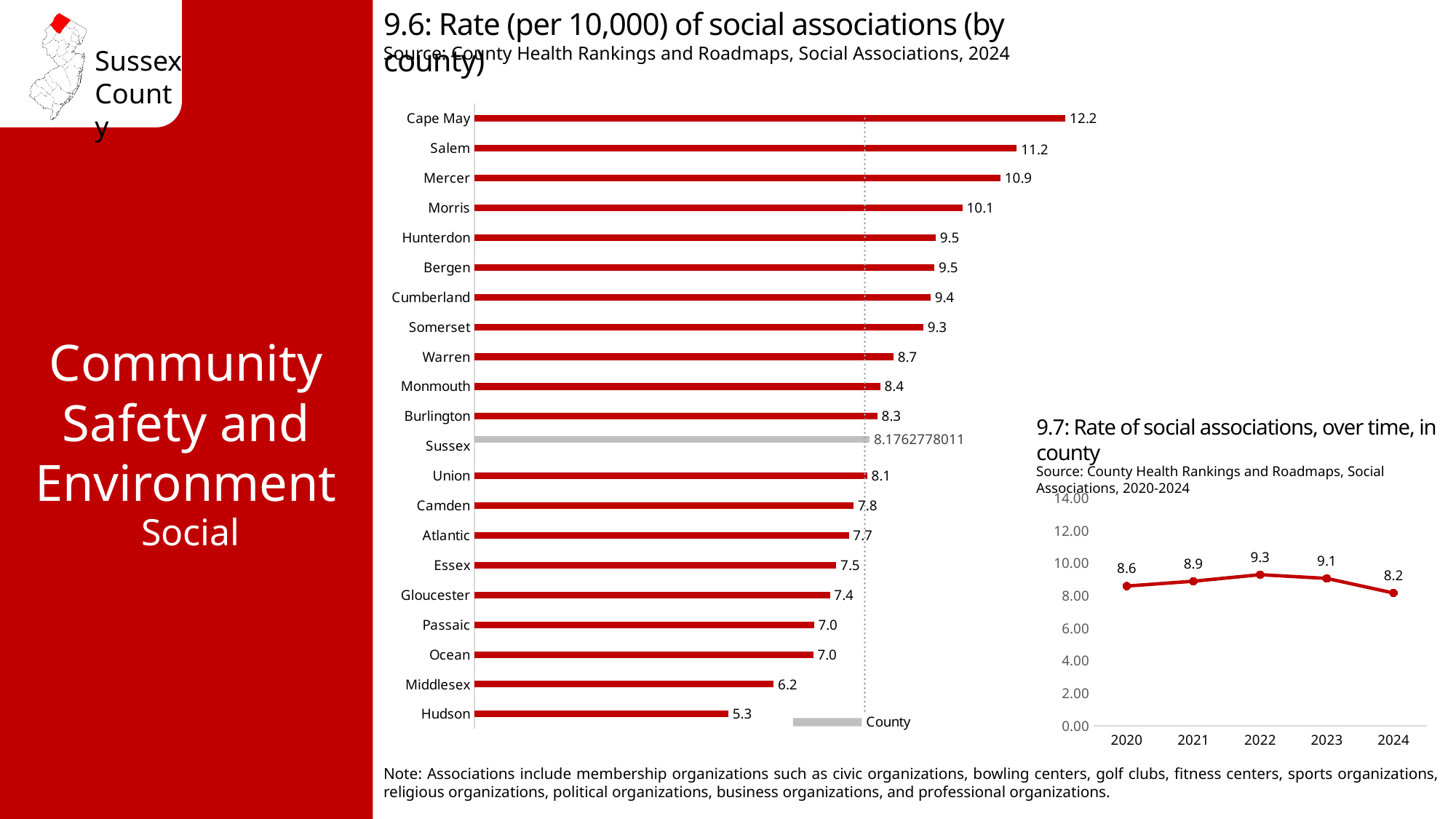
What kind of chart is chart 9.7 (rate of social associations over time)? Line chart In chart 9.7 (rate of social associations over time), what is the value for 2022? 9.3 In chart 9.6 (rate of social associations by county), how many counties are plotted? 21 What kind of chart is chart 9.6 (rate of social associations by county)? Bar chart In chart 9.6 (rate of social associations by county), what is the value for Cape May? 12.2 In chart 9.6 (rate of social associations by county), which county has the highest rate? Cape May In chart 9.7 (rate of social associations over time), what is the difference between the 2022 and 2024 values? 1.1 In chart 9.6 (rate of social associations by county), which county has the lowest rate? Hudson In chart 9.6 (rate of social associations by county), what is the difference between Salem and Mercer? 0.3 In chart 9.6 (rate of social associations by county), what is the value shown for Sussex? 8.1762778011 In chart 9.6 (rate of social associations by county), which is larger, the value for Warren or the value for Monmouth? Warren In chart 9.7 (rate of social associations over time), which year has the lowest value? 2024